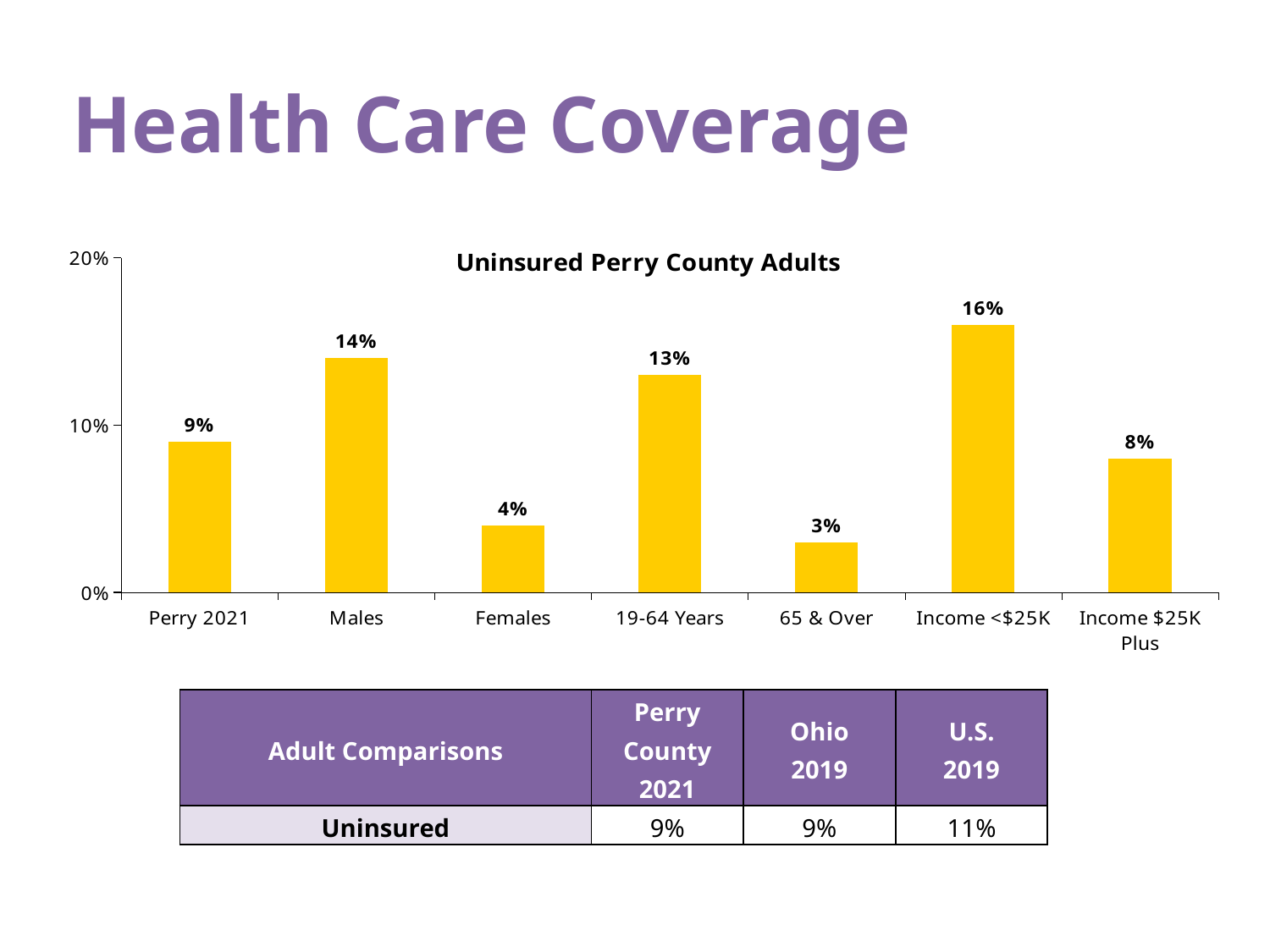
What is the value for 65 & Over in the Uninsured Perry County Adults chart? 3% Which category has the highest value in the Uninsured Perry County Adults chart? Income <$25K What is the difference between the values for Males and Females in the Uninsured Perry County Adults chart? 10% What is the title of the chart on the slide? Uninsured Perry County Adults What is the value for Income <$25K in the Uninsured Perry County Adults chart? 16% What is the value for Males in the Uninsured Perry County Adults chart? 14% Which is larger in the Uninsured Perry County Adults chart, the value for 19-64 Years or the value for Income $25K Plus? 19-64 Years What kind of chart is the Uninsured Perry County Adults chart? Bar chart Which category has the lowest value in the Uninsured Perry County Adults chart? 65 & Over Is the value for Perry 2021 in the Uninsured Perry County Adults chart greater or less than 10%? less How many categories are shown in the Uninsured Perry County Adults chart? 7 What is the difference between the values for Income <$25K and Income $25K Plus in the Uninsured Perry County Adults chart? 8%